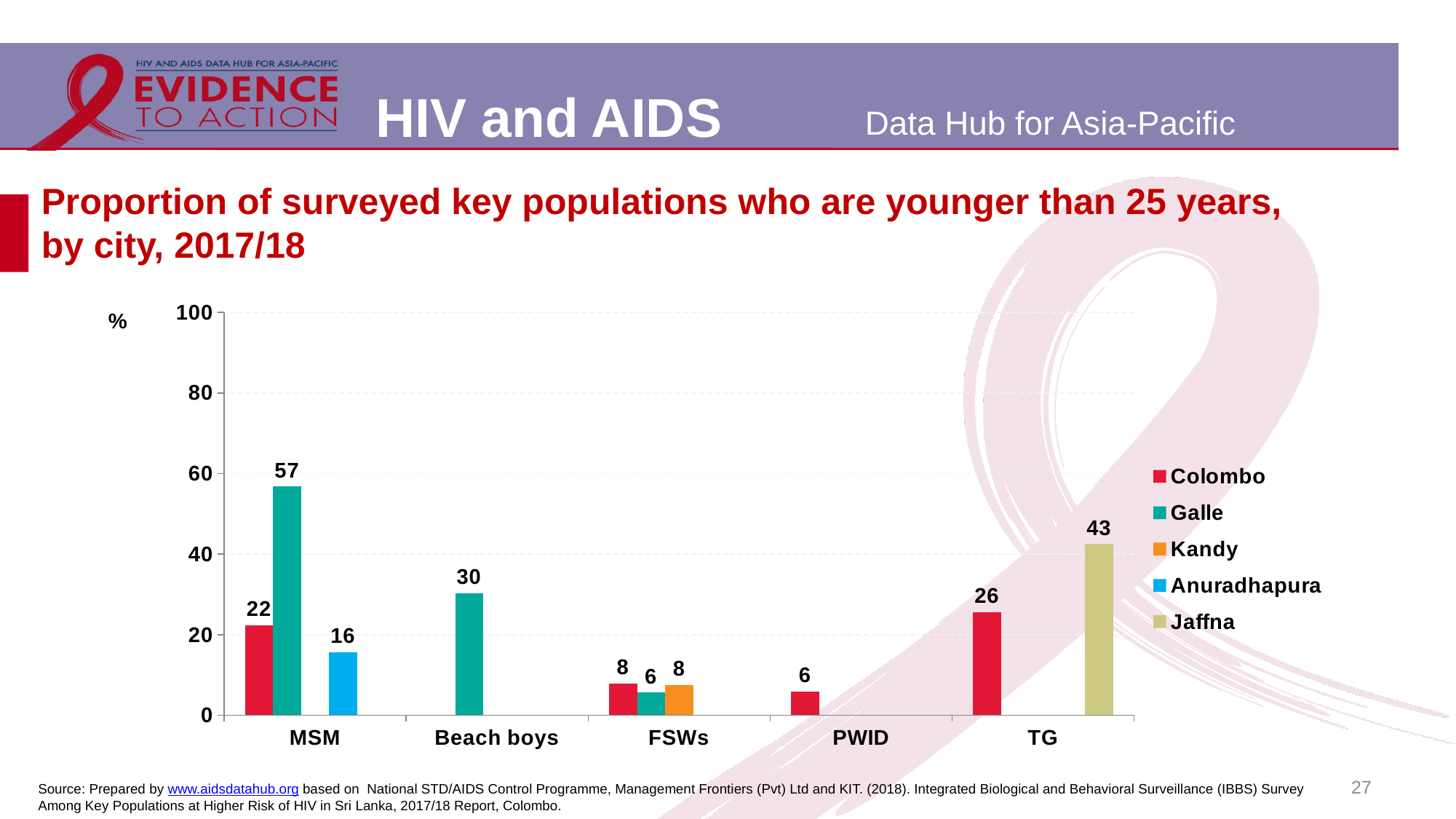
What is the value for Galle among Beach boys? 30 Which city has the highest value among MSM? Galle What is the difference between the Galle and Colombo values among MSM? 35 What kind of chart is shown on the slide? Bar chart What is the value for Colombo among MSM? 22 Which is larger: the Colombo value for TG or the Jaffna value for TG? Jaffna What is the value for Jaffna among TG? 43 Which city has the lowest value among FSWs? Galle What is the value for Anuradhapura among MSM? 16 How many cities does the legend list? 5 What is the value for Galle among MSM? 57 What is the value for Colombo among PWID? 6